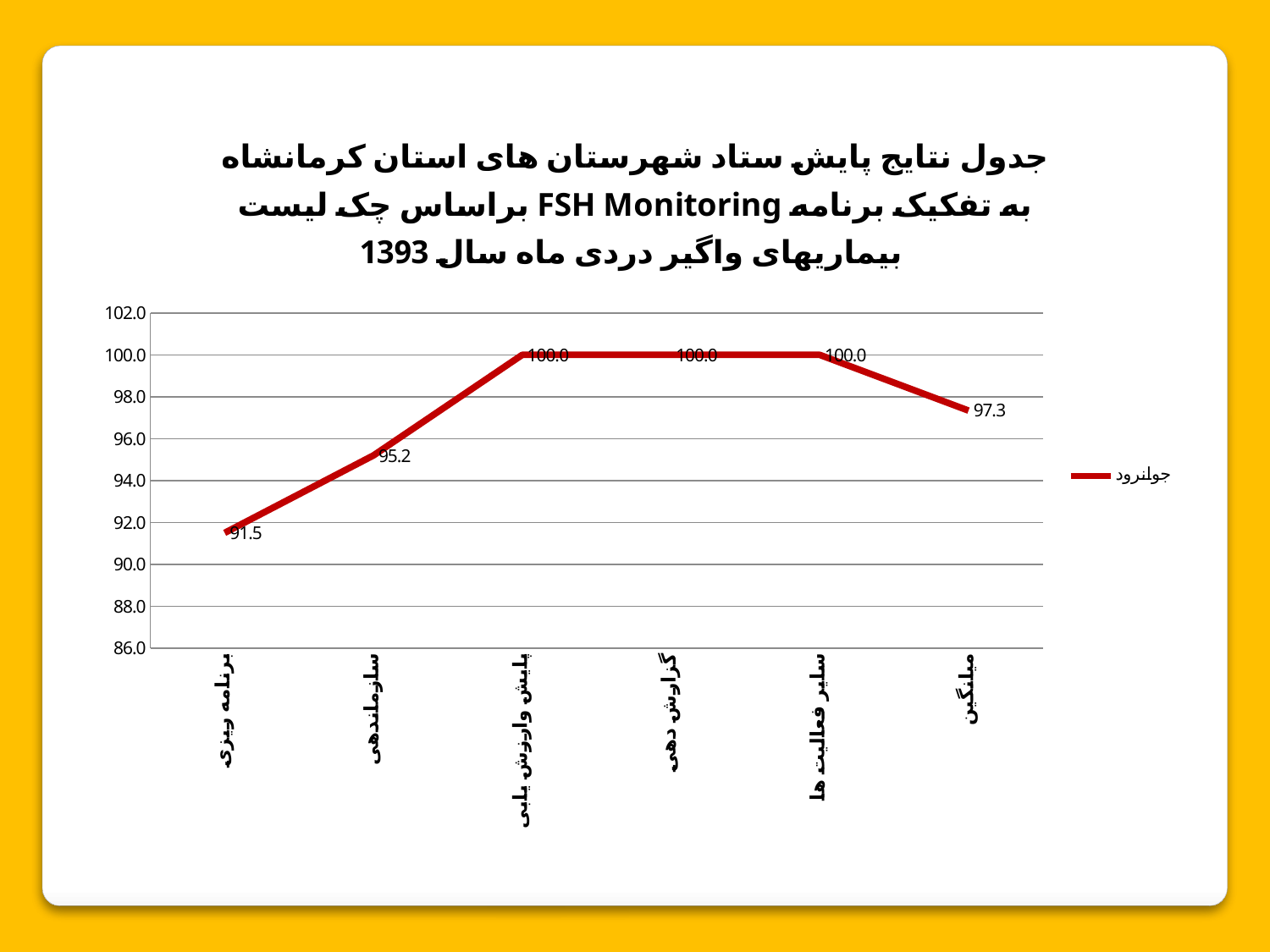
How many categories are shown on the x axis? 6 What is the value for میانگین? 97.3 What is the value for گزارش دهی? 100.0 What is the difference between the values for سازماندهی and برنامه ریزی? 3.7 Is the value for برنامه ریزی greater or less than 92.0? less What is the value for برنامه ریزی? 91.5 What is the difference between the values for گزارش دهی and میانگین? 2.7 What is the value for سازماندهی? 95.2 What kind of chart is shown on the slide? line chart Which is larger, the value for سازماندهی or the value for میانگین? میانگین How many series does the legend list? 1 Which category has the lowest value? برنامه ریزی